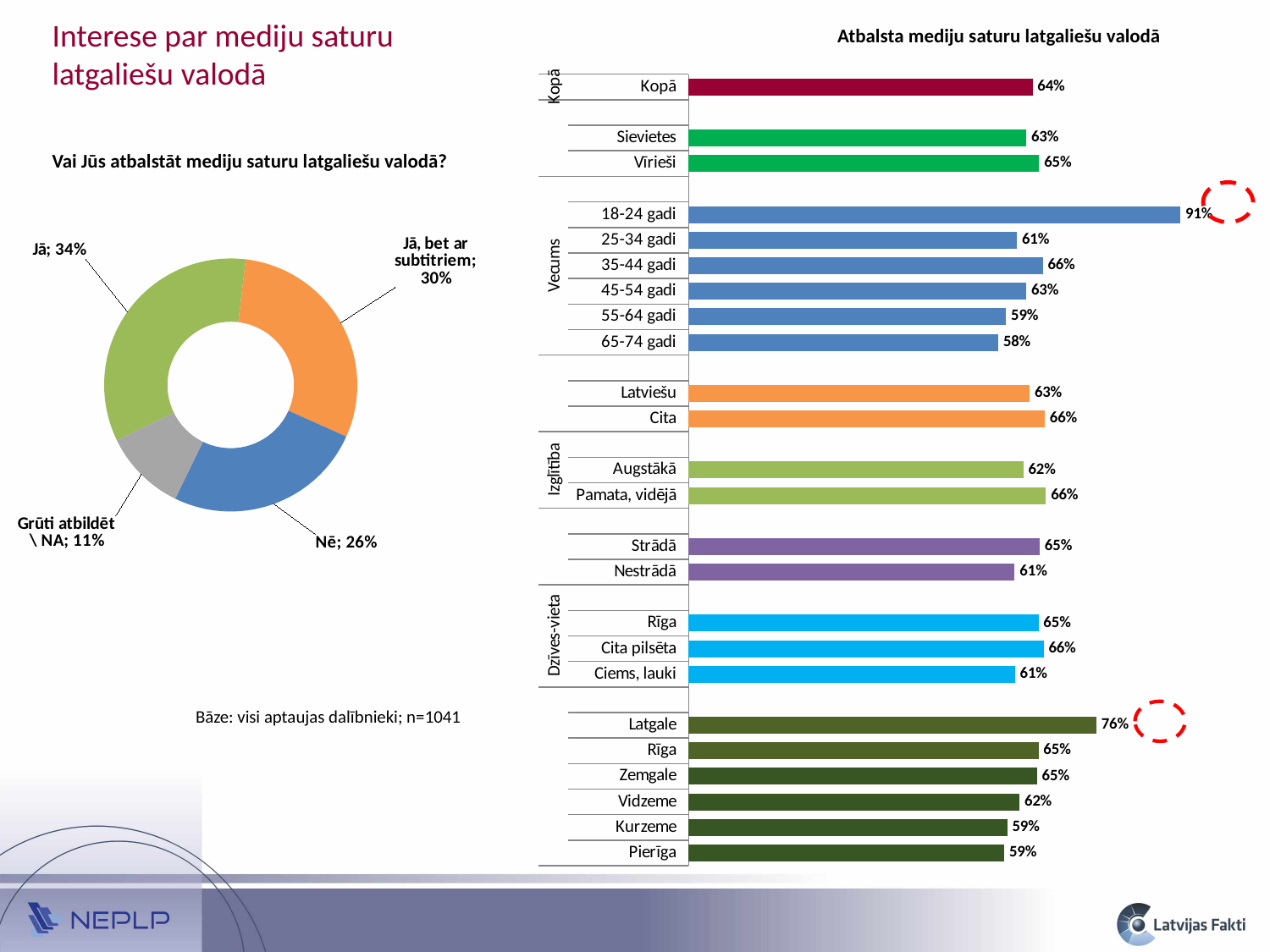
What kind of chart is shown on the right side of the slide? Bar chart In the bar chart on the right, which category has the highest value? 18-24 gadi In the bar chart on the right, which is larger, Sievietes or Vīrieši? Vīrieši In the donut chart on the left, how many slices are there? 4 In the donut chart on the left, what share of respondents answered "Nē"? 26% In the donut chart on the left, which answer has the smallest share? Grūti atbildēt \ NA In the donut chart on the left, what share of respondents answered "Jā"? 34% What is the title of the chart on the right side of the slide? Atbalsta mediju saturu latgaliešu valodā In the bar chart on the right, what is the difference between Latgale and Kurzeme? 17% In the bar chart on the right, what is the value for 18-24 gadi? 91% In the bar chart on the right, what is the value for Ciems, lauki? 61% In the bar chart on the right, what is the value for Kopā? 64%